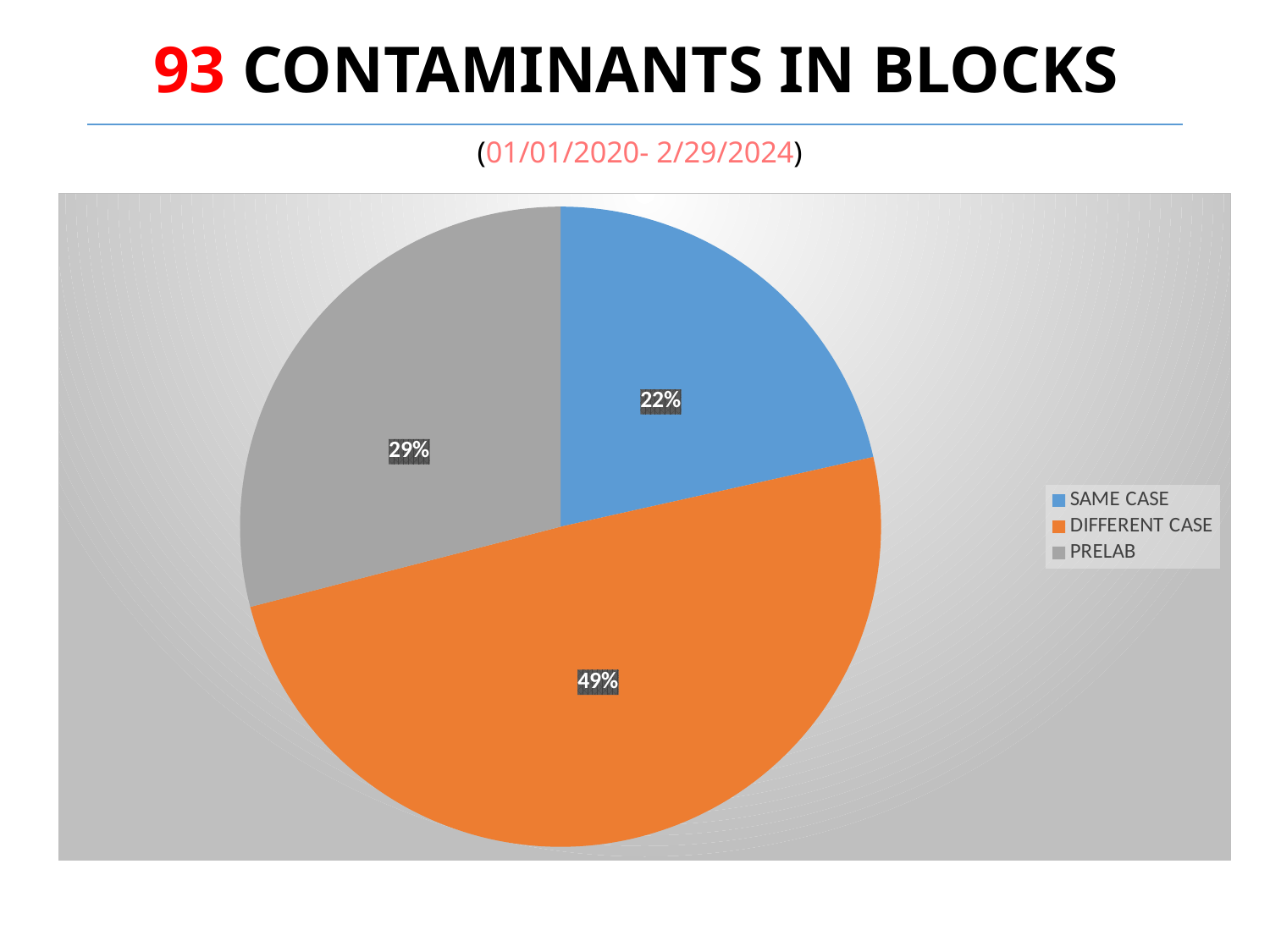
Which category has the largest share of the pie? DIFFERENT CASE What percentage of the pie is labelled for PRELAB? 29% What percentage of the pie is labelled for SAME CASE? 22% What kind of chart is shown on the slide? pie chart What is the difference in percentage points between DIFFERENT CASE and PRELAB? 20 Which is larger, the share for PRELAB or the share for SAME CASE? PRELAB Which category has the smallest share of the pie? SAME CASE What is the difference in percentage points between PRELAB and SAME CASE? 7 How many entries does the legend list? 3 How many slices does the pie chart have? 3 What colour is the DIFFERENT CASE slice? orange What percentage of the pie is labelled for DIFFERENT CASE? 49%